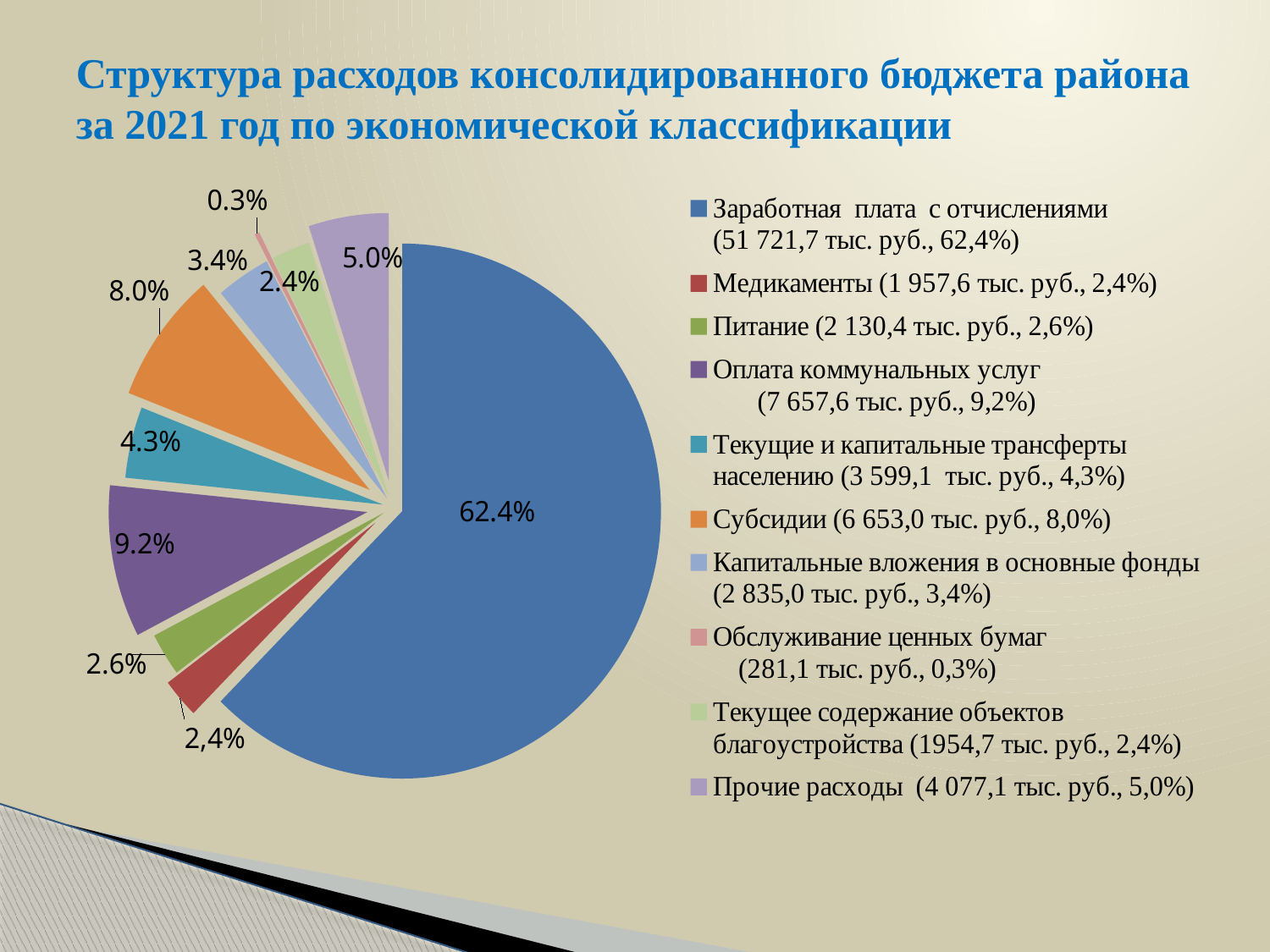
What is the title of the slide's chart? Структура расходов консолидированного бюджета района за 2021 год по экономической классификации What share of the pie does Субсидии account for? 8.0% Which category has the largest share of the pie? Заработная плата с отчислениями What kind of chart is shown on the slide? pie chart According to the legend, what is the amount in thousand rubles for Медикаменты? 1 957,6 тыс. руб. Which category has the smallest share of the pie? Обслуживание ценных бумаг How many slices does the pie chart have? 10 What is the difference in percentage points between the share of Заработная плата с отчислениями (62.4%) and Оплата коммунальных услуг (9.2%)? 53.2 percentage points According to the legend, what is the amount in thousand rubles for Заработная плата с отчислениями? 51 721,7 тыс. руб. What share of the pie does Оплата коммунальных услуг account for? 9.2% Which has the larger share: Субсидии or Текущие и капитальные трансферты населению? Субсидии What share of the pie does Прочие расходы account for? 5.0%